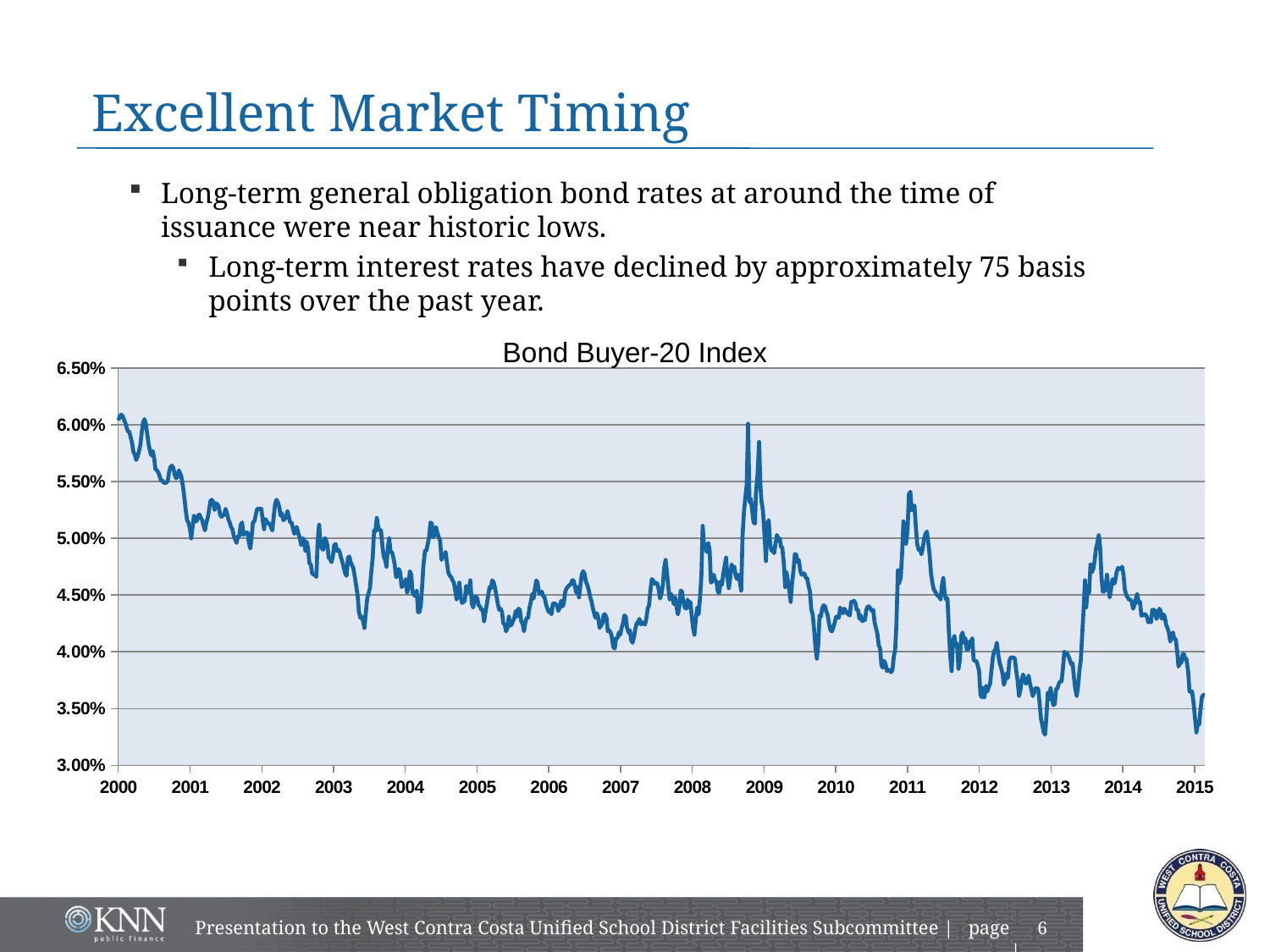
Overall, do the values in the Bond Buyer-20 Index chart rise or fall from 2000 to 2015? fall Is the value at the start of 2007 greater or less than 4.50%? less Which is larger, the value at the start of 2000 or the value at the start of 2015? 2000 What is the highest value shown on the y axis of the chart? 6.50% What is the title of the chart? Bond Buyer-20 Index Is the value at the start of 2013 greater or less than 4.00%? less Is the value at the start of 2000 greater or less than 5.50%? greater Which is larger, the value at the start of 2003 or the value at the start of 2013? 2003 How many year labels are shown on the x axis of the chart? 16 What kind of chart is shown on the slide? line chart